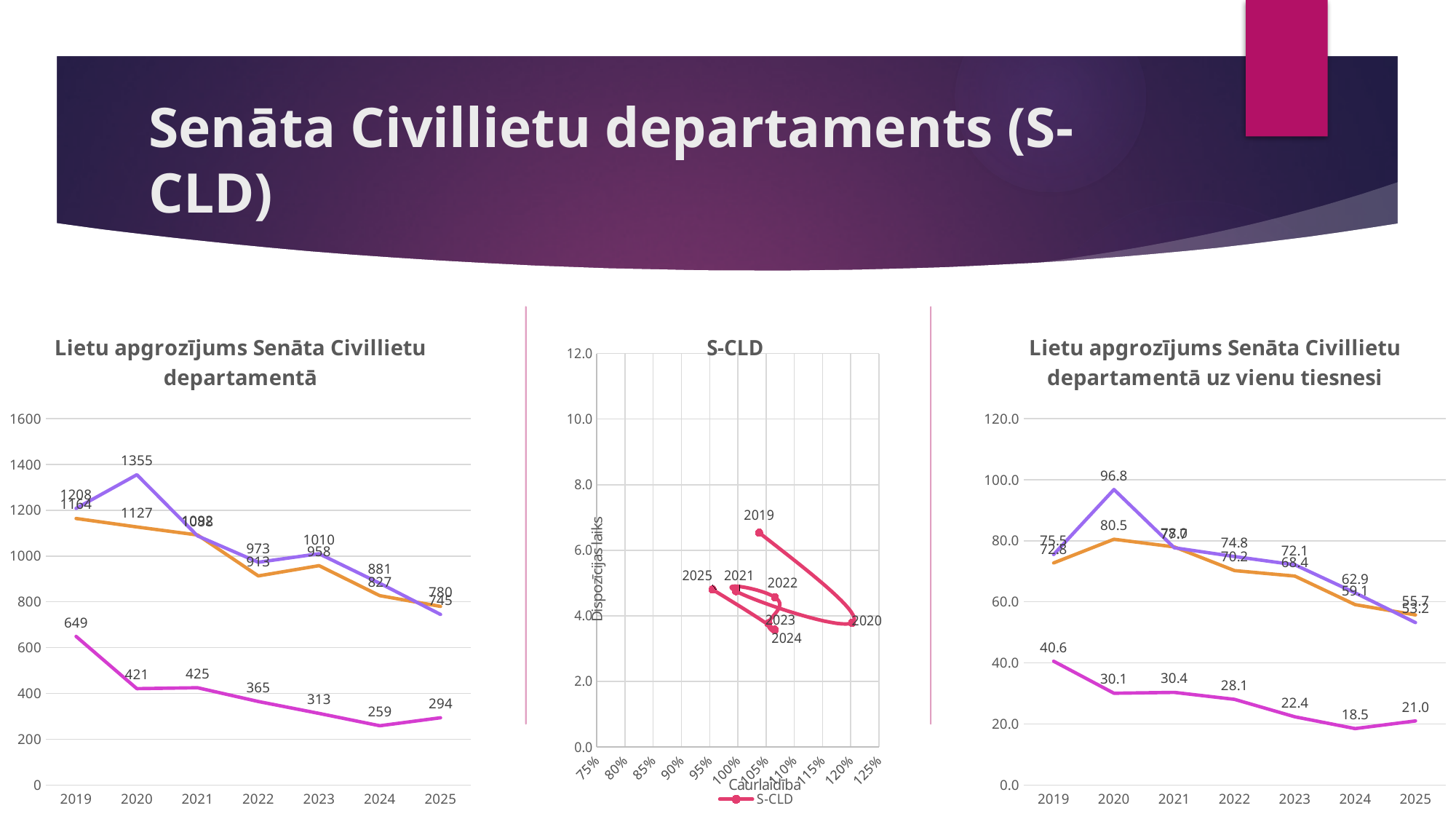
In the left chart 'Lietu apgrozījums Senāta Civillietu departamentā', what is the difference between the purple line's 2020 value and its 2025 value? 610 In the right chart 'Lietu apgrozījums Senāta Civillietu departamentā uz vienu tiesnesi', which is larger in 2019: the purple line or the orange line? purple line In the right chart 'Lietu apgrozījums Senāta Civillietu departamentā uz vienu tiesnesi', what is the value of the magenta line in 2024? 18.5 In the left chart 'Lietu apgrozījums Senāta Civillietu departamentā', how many years are shown on the x axis? 7 In the middle chart 'S-CLD', how many series does the legend list? 1 In the left chart 'Lietu apgrozījums Senāta Civillietu departamentā', what is the value of the purple line in 2020? 1355 In the right chart 'Lietu apgrozījums Senāta Civillietu departamentā uz vienu tiesnesi', what is the difference between the orange line's 2020 value and its 2025 value? 24.8 In the left chart 'Lietu apgrozījums Senāta Civillietu departamentā', does the magenta line generally rise or fall from 2019 to 2024? fall In the right chart 'Lietu apgrozījums Senāta Civillietu departamentā uz vienu tiesnesi', what is the value of the purple line in 2020? 96.8 In the left chart 'Lietu apgrozījums Senāta Civillietu departamentā', what is the value of the magenta line in 2024? 259 In the left chart 'Lietu apgrozījums Senāta Civillietu departamentā', in which year is the magenta line at its highest? 2019 In the middle chart 'S-CLD', is the Dispozīcijas laiks value for 2019 greater or less than 6.0? greater